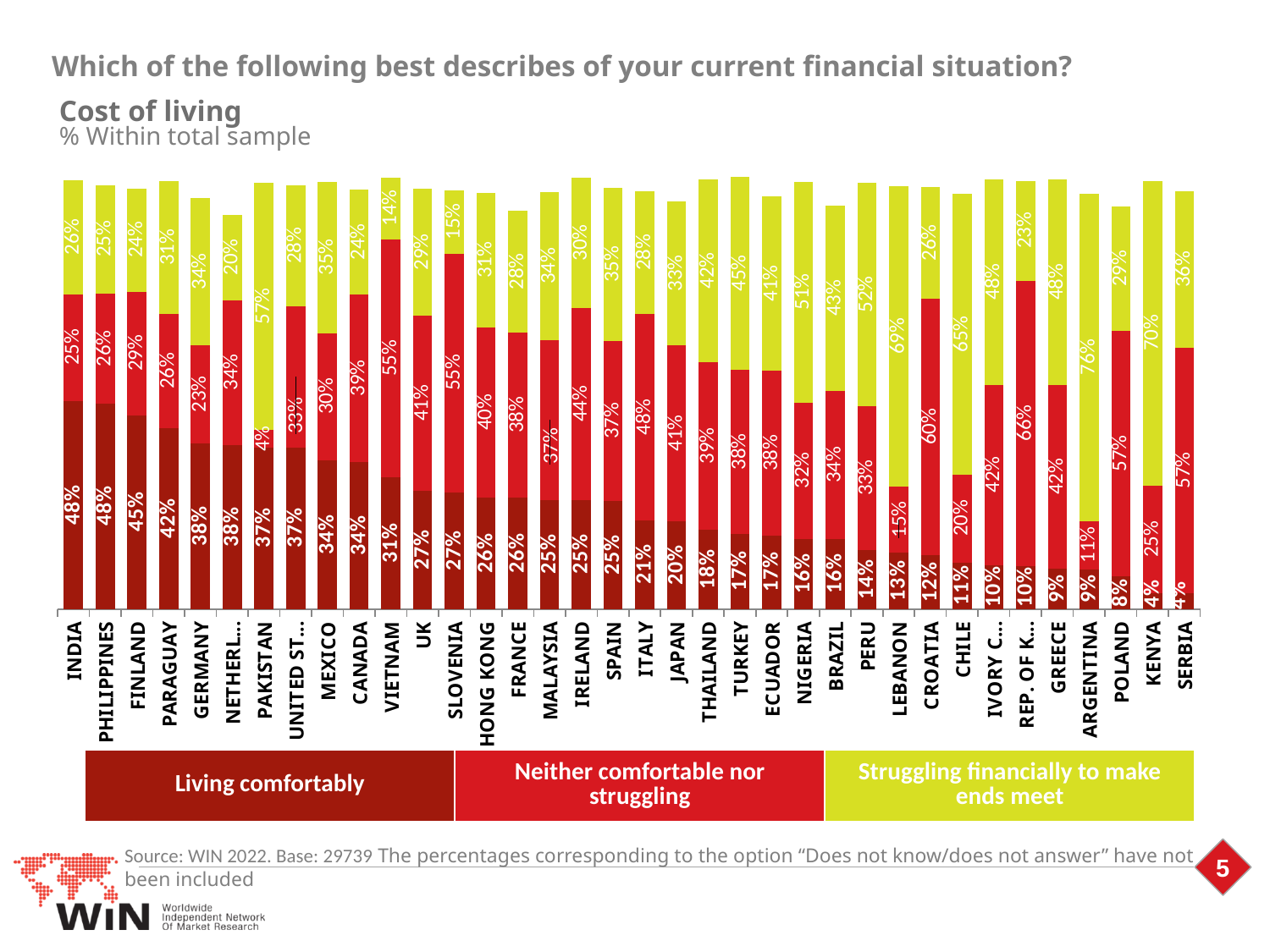
What percentage of respondents in India are living comfortably? 48% What percentage of respondents in Croatia are neither comfortable nor struggling? 60% What is the difference between the living comfortably percentages for Finland and Germany? 7% Which country has the highest percentage struggling financially to make ends meet? Argentina How many series does the legend list? 3 What percentage of respondents in Argentina are struggling financially to make ends meet? 76% Which country has the lowest percentage struggling financially to make ends meet? Vietnam What percentage of respondents in Pakistan are neither comfortable nor struggling? 4% How many countries are shown on the chart? 36 Which has a higher percentage living comfortably, Japan or Thailand? Japan What kind of chart is shown on the slide? Stacked bar chart What is the total of the three segments for India? 99%